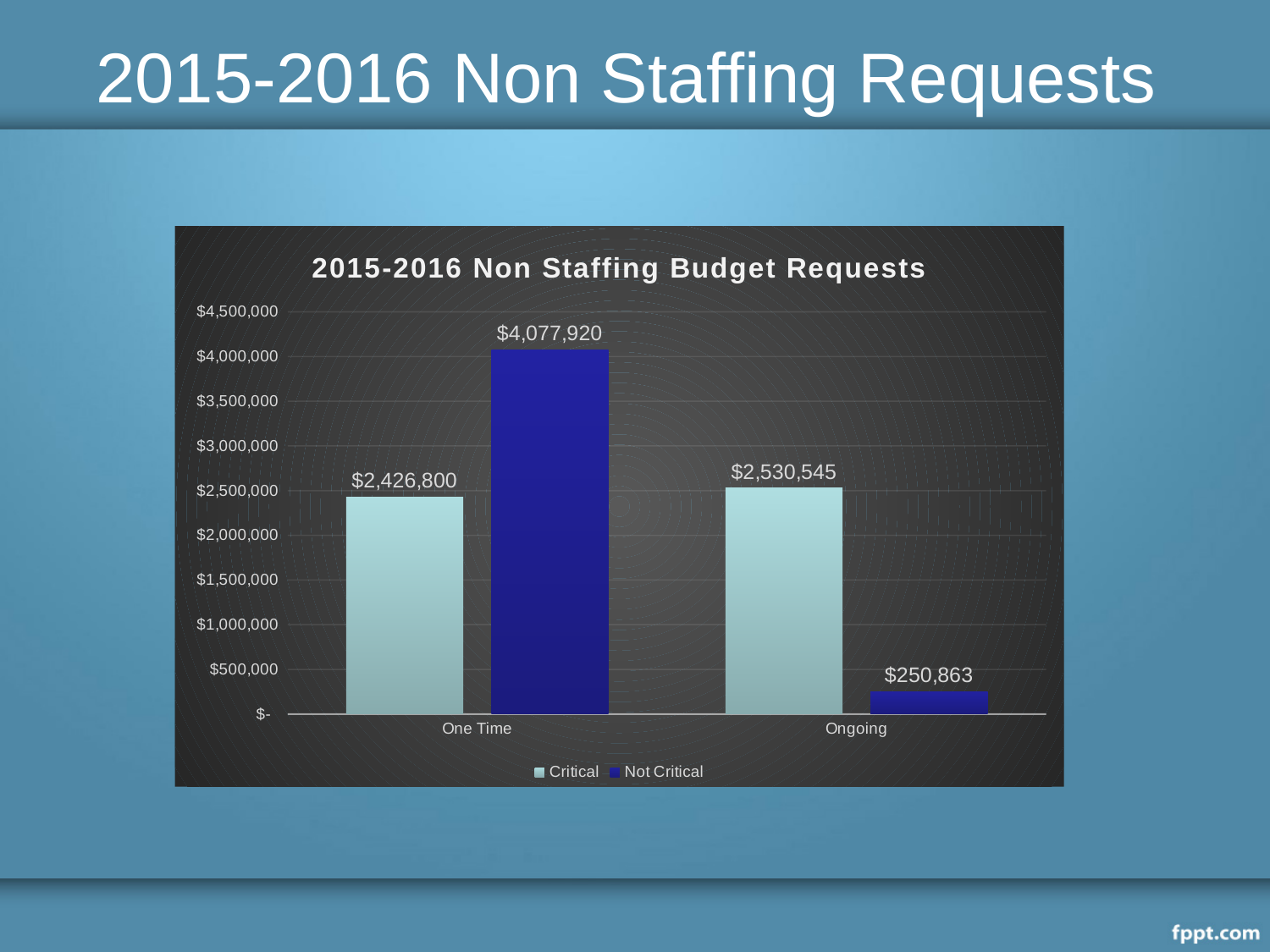
What is the value for Critical in the Ongoing category? $2,530,545 What is the difference between the Not Critical and Critical values in the One Time category? $1,651,120 How many series does the legend list? 2 What is the value for Critical in the One Time category? $2,426,800 What is the value for Not Critical in the Ongoing category? $250,863 Which bar has the lowest value on the chart? Not Critical, Ongoing Which bar has the highest value on the chart? Not Critical, One Time What is the title of the chart? 2015-2016 Non Staffing Budget Requests Which is larger: the Critical value for One Time or the Critical value for Ongoing? Critical value for Ongoing What is the difference between the Critical and Not Critical values in the Ongoing category? $2,279,682 What kind of chart is shown on the slide? Bar chart What is the value for Not Critical in the One Time category? $4,077,920